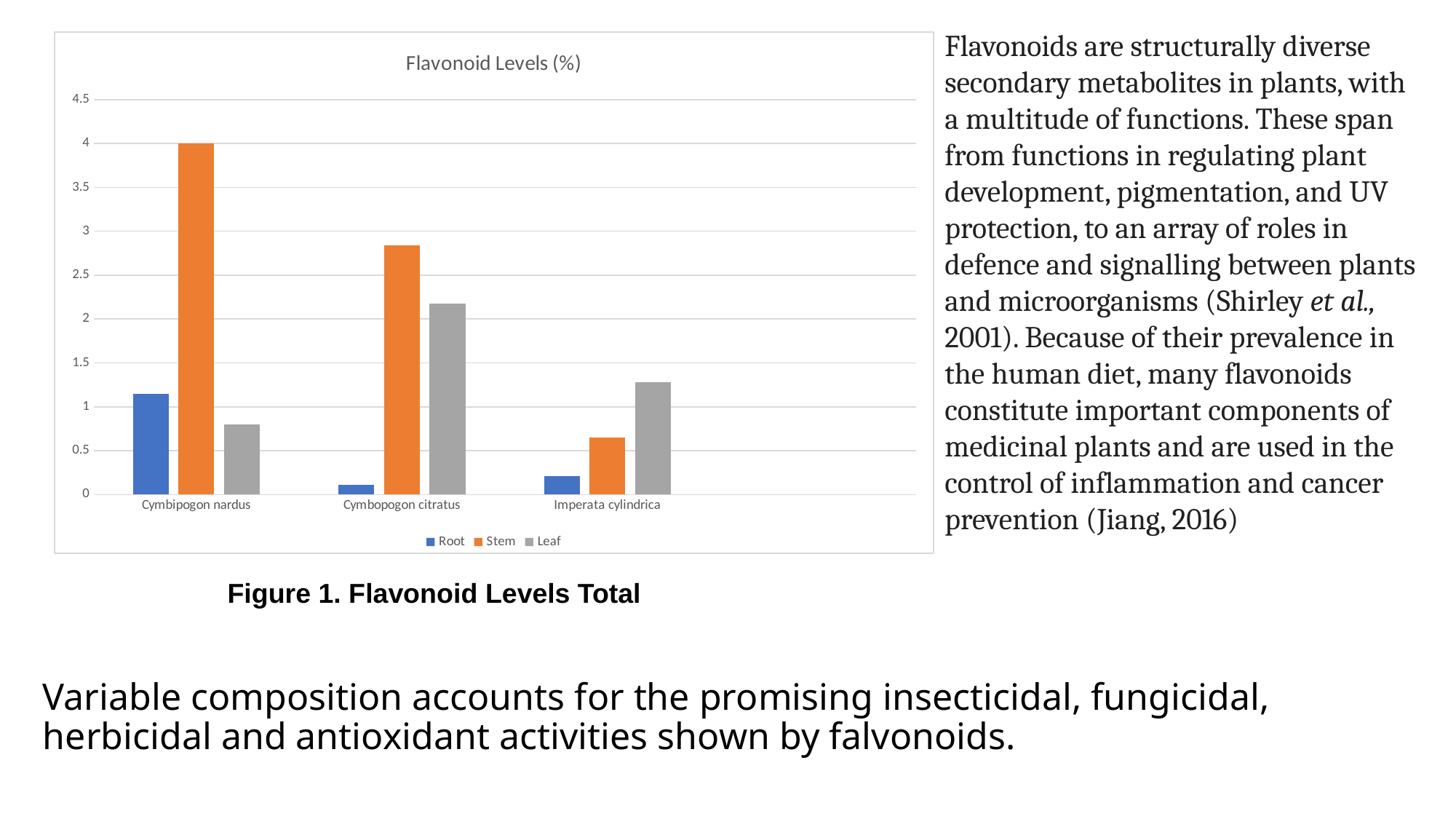
Is the Stem value for Cymbopogon citratus greater or less than 2.5? greater Which plant has the highest Stem flavonoid level? Cymbipogon nardus How many series does the legend of the Flavonoid Levels (%) chart list? 3 For Imperata cylindrica, which is larger: the Stem value or the Leaf value? Leaf What kind of chart is shown on the slide? bar chart How many plant species (categories) are shown on the x axis of the chart? 3 For Cymbipogon nardus, which is larger: the Root value or the Leaf value? Root What is the title of the chart? Flavonoid Levels (%) Which plant has the lowest Root flavonoid level? Cymbopogon citratus Is the Root value for Cymbipogon nardus greater or less than 1? greater Is the Leaf value for Cymbopogon citratus greater or less than 2? greater What is the Stem value for Cymbipogon nardus? 4